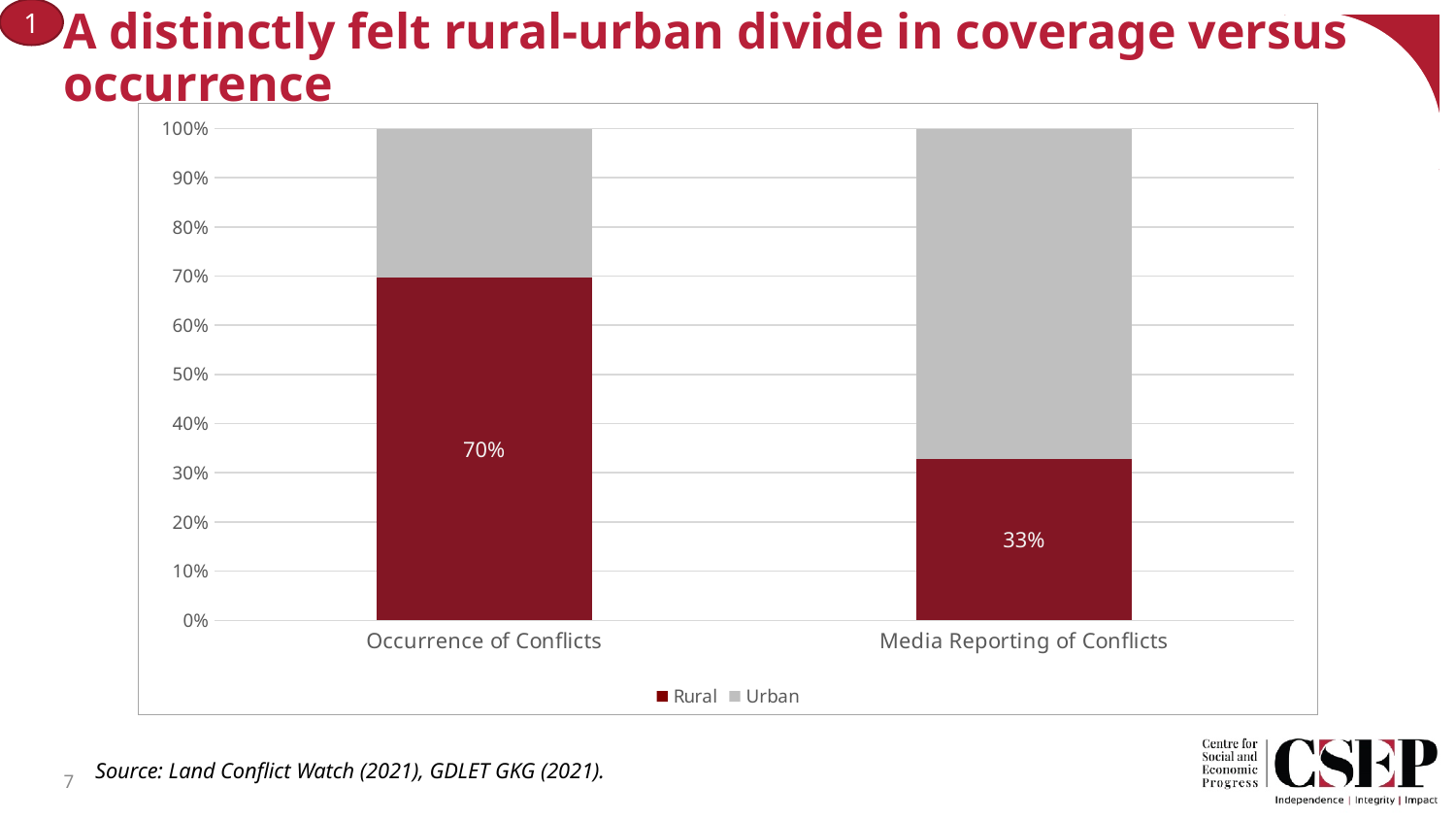
Which category has the higher Rural share? Occurrence of Conflicts What is the Rural share for Occurrence of Conflicts? 70% What is the difference between the Rural share for Occurrence of Conflicts and the Rural share for Media Reporting of Conflicts? 37% How many series does the legend list? 2 Is the Rural share larger for Occurrence of Conflicts or for Media Reporting of Conflicts? Occurrence of Conflicts What is the Rural share for Media Reporting of Conflicts? 33% Is the Urban share for Media Reporting of Conflicts greater or less than 50%? greater Which category has the lower Rural share? Media Reporting of Conflicts Which series is shown in dark red in the legend? Rural What kind of chart is shown on the slide? Stacked bar chart How many categories are shown on the x axis? 2 Is the Urban share for Occurrence of Conflicts greater or less than 50%? less